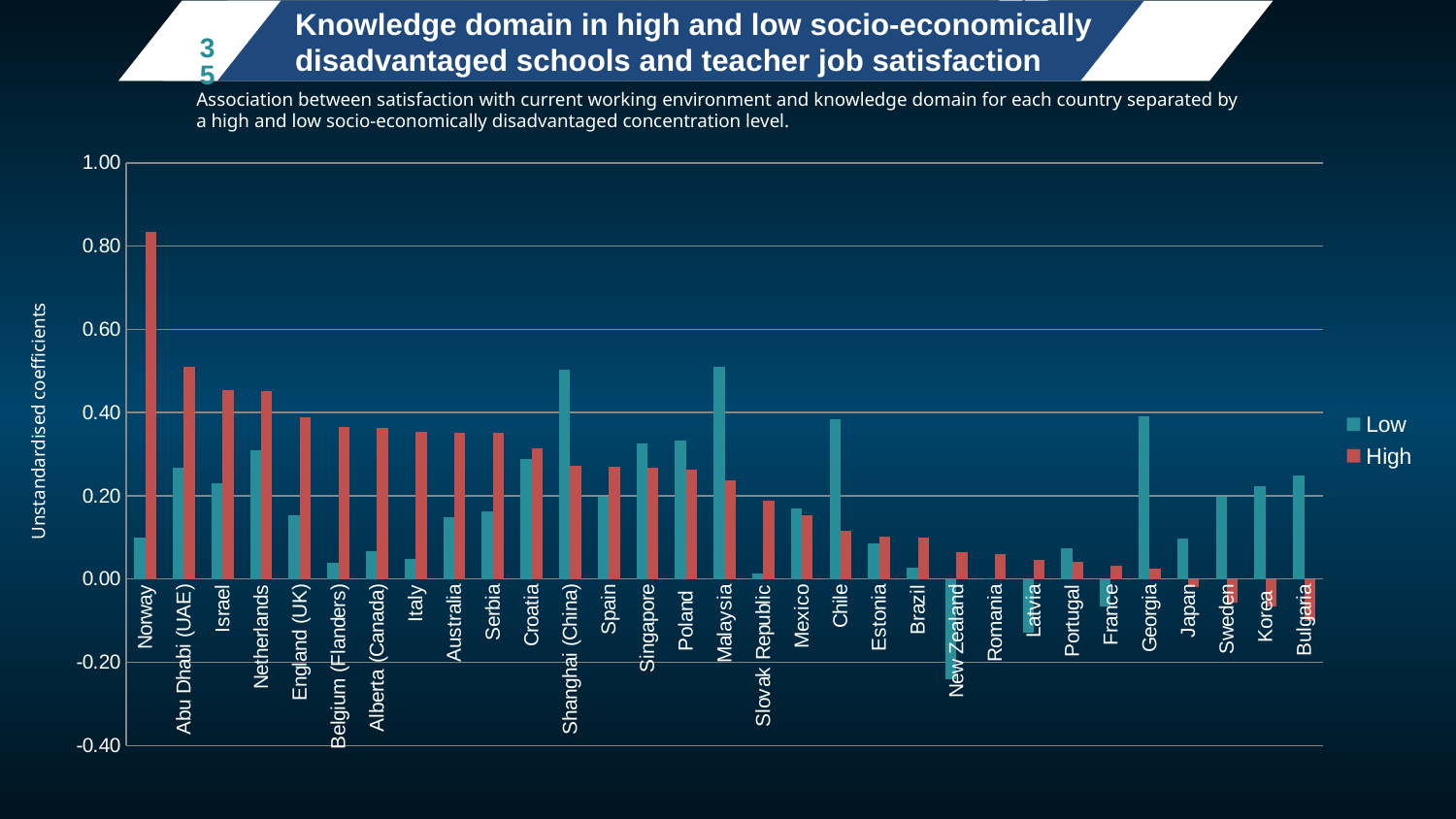
How many countries or regions are shown on the x axis? 31 For Malaysia, which is larger: the Low value or the High value? Low How many series does the legend list? 2 What is the label on the vertical axis? Unstandardised coefficients For Norway, which is larger: the Low value or the High value? High Is the High value for Norway greater or less than 0.60? greater What kind of chart is shown on the slide? bar chart Do the High series values generally rise or fall from left to right along the x axis? fall Which country has the highest value for the High series? Norway Which country has the lowest value for the Low series? New Zealand Is the High value for Abu Dhabi (UAE) greater or less than 0.40? greater Is the Low value for New Zealand greater or less than 0.00? less